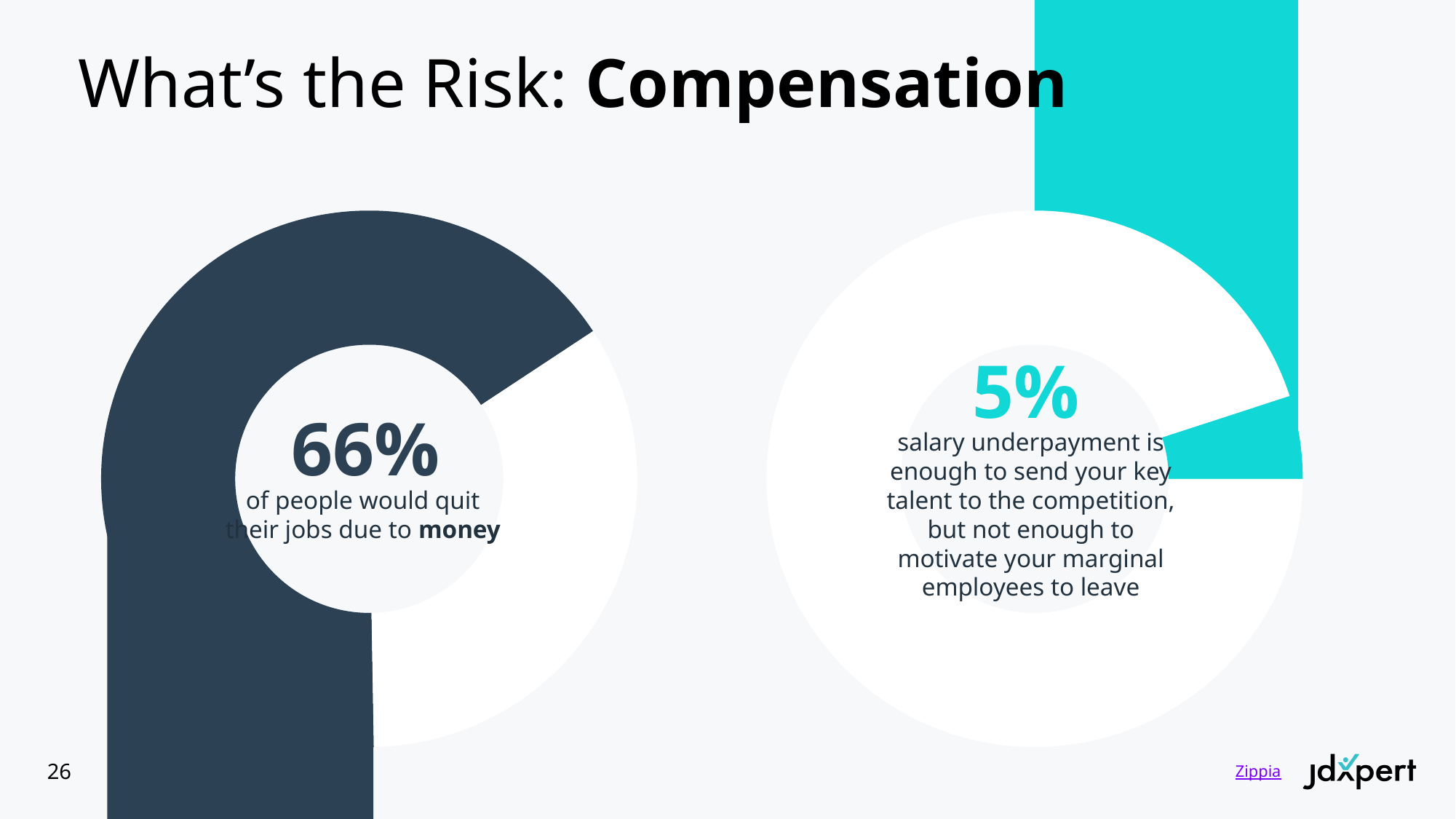
What share of the left chart's donut does the highlighted segment represent? 66% What colour is the filled portion of the left chart? Dark navy blue What kind of chart is used on the right side of the slide? Donut (pie) chart On the left chart, what percentage of people would quit their jobs due to money? 66% Which chart shows the larger percentage, the left chart or the right chart? The left chart What kind of chart is used on the left side of the slide? Donut (pie) chart Is the value shown on the right chart greater or less than 10%? less How many charts are shown on the slide? 2 Is the value shown on the left chart greater or less than 50%? greater What is the difference between the percentage on the left chart and the percentage on the right chart? 61% On the right chart, what percentage of salary underpayment is enough to send key talent to the competition? 5% What colour is the filled portion of the right chart? Teal